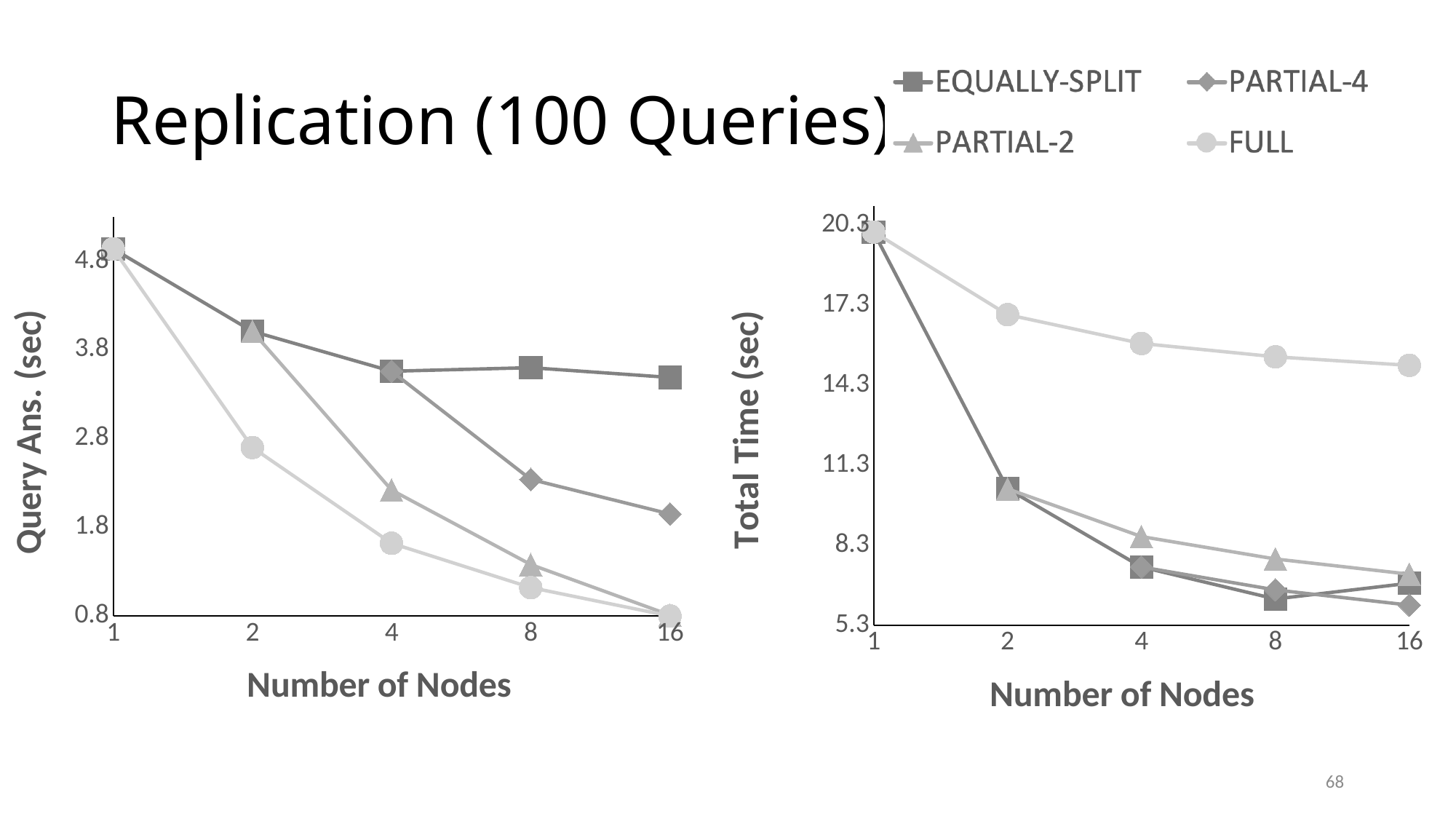
In the left chart (Query Ans. (sec)), which series has the lowest value at 2 nodes? FULL What is the x-axis label of the right chart (Total Time (sec))? Number of Nodes In the left chart (Query Ans. (sec)), at 8 nodes, which is larger: EQUALLY-SPLIT or PARTIAL-2? EQUALLY-SPLIT In the right chart (Total Time (sec)), which series has the lowest value at 16 nodes? PARTIAL-4 In the left chart (Query Ans. (sec)), how many node counts are plotted along the x axis? 5 In the right chart (Total Time (sec)), which series has the highest value at 16 nodes? FULL How many series does the legend list? 4 In the left chart (Query Ans. (sec)), is the value for FULL at 4 nodes greater or less than 1.8? less In the left chart (Query Ans. (sec)), which series has the highest value at 16 nodes? EQUALLY-SPLIT What kind of chart is the left chart (Query Ans. (sec))? line chart In the right chart (Total Time (sec)), is the value for EQUALLY-SPLIT at 2 nodes greater or less than 11.3? less In the right chart (Total Time (sec)), does the FULL series rise or fall as the number of nodes increases? fall